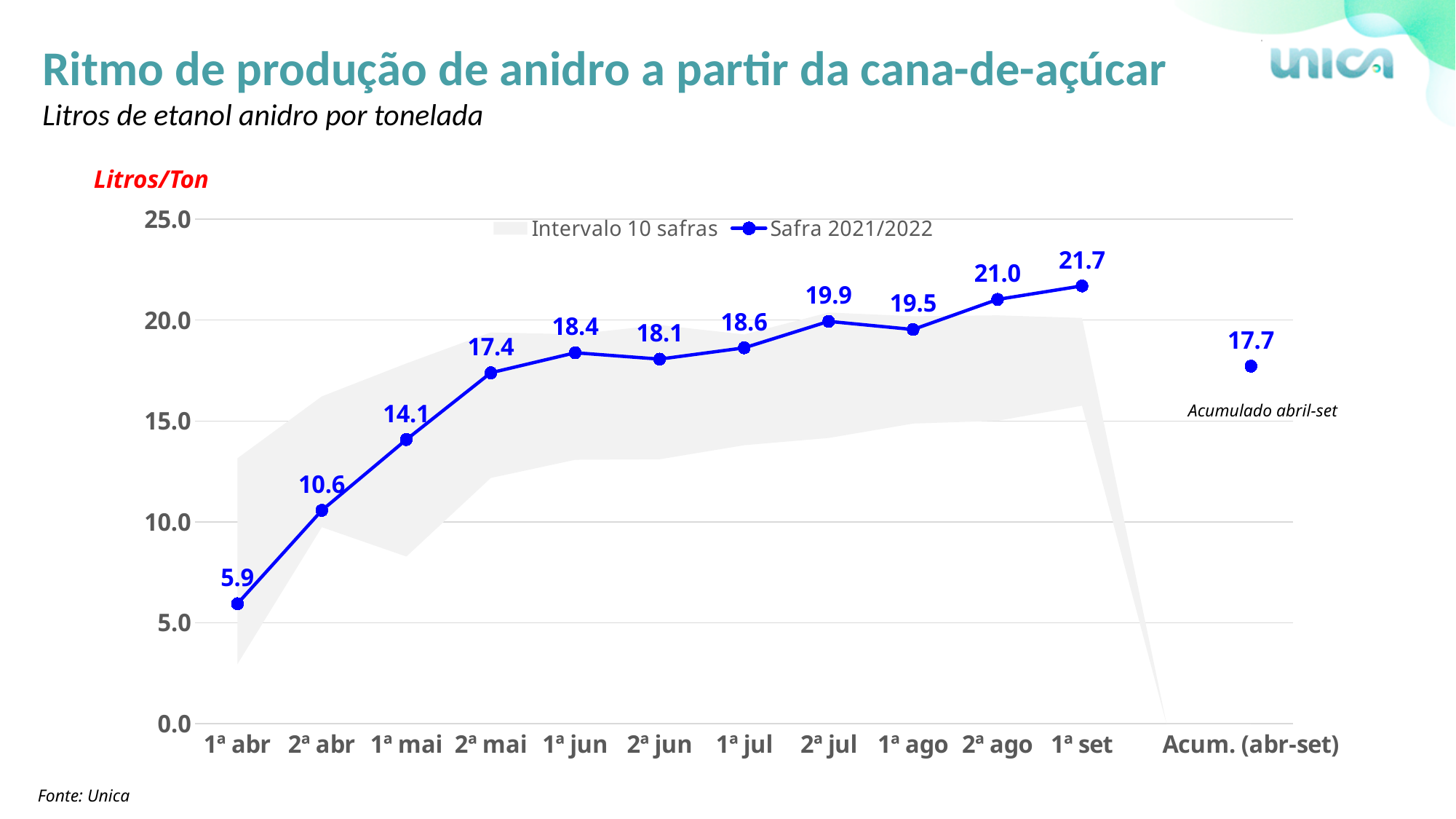
What is the value for Safra 2021/2022 at 2ª jul? 19.9 What is the unit label shown in red above the y axis? Litros/Ton How many categories are shown on the x axis? 12 Is the Safra 2021/2022 value at 2ª ago greater or less than 20.0? greater Which category has the highest value for Safra 2021/2022? 1ª set What is the value for Safra 2021/2022 at 1ª abr? 5.9 Which category has the lowest value for Safra 2021/2022? 1ª abr What kind of chart is shown on the slide? combination area and line chart (a line with a shaded area band) How many series does the legend list? 2 What is the difference between the Safra 2021/2022 values at 1ª set and 1ª abr? 15.8 Which is larger for Safra 2021/2022: the value at 1ª jun or at 2ª jun? 1ª jun What is the value shown for Acum. (abr-set)? 17.7